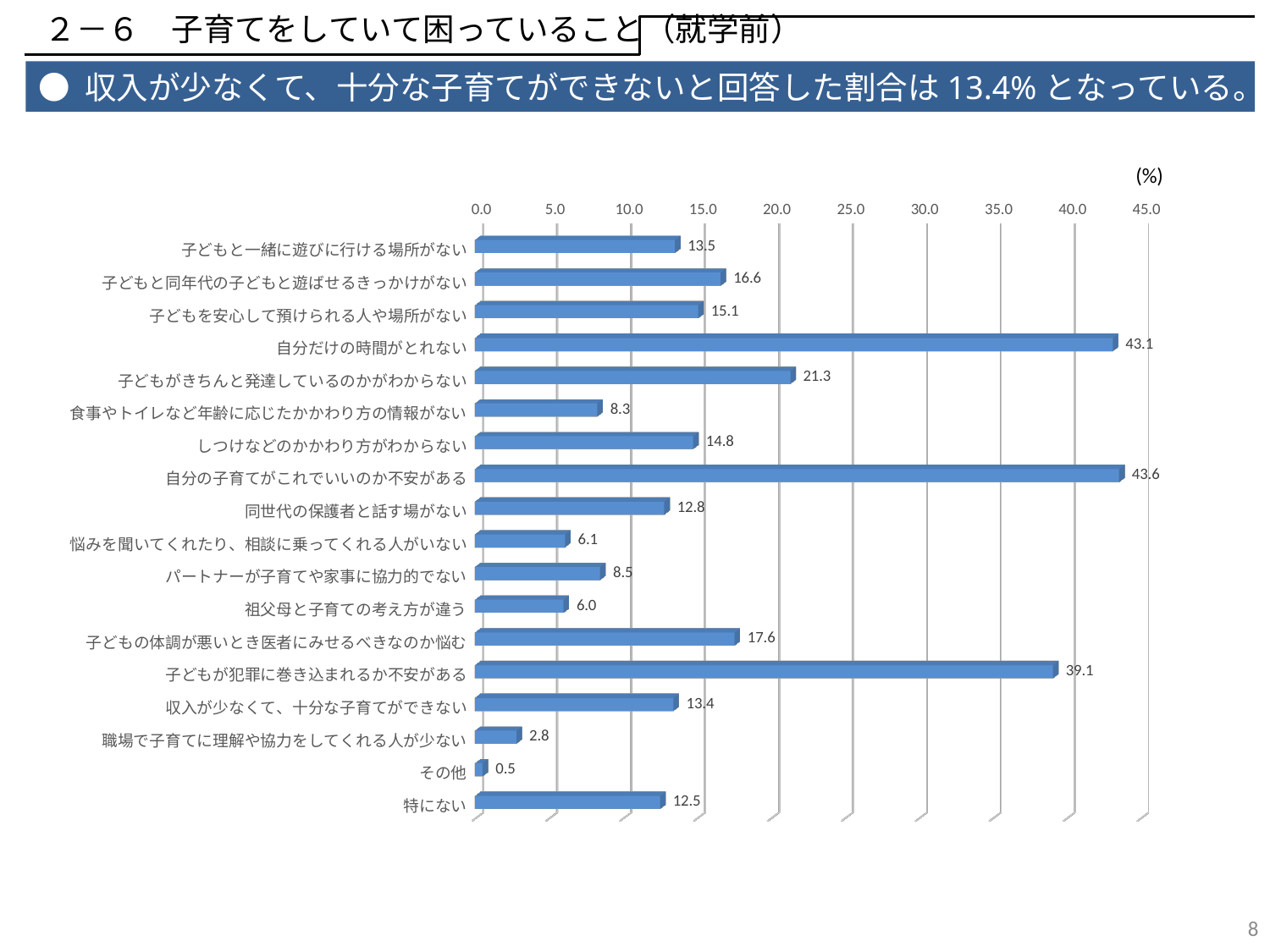
Which category has the lowest value? その他 What is the value for 子どもが犯罪に巻き込まれるか不安がある? 39.1 What unit is indicated at the top right of the chart's axis? (%) What is the value for 特にない? 12.5 What kind of chart is shown on the slide? bar chart Which category has the highest value? 自分の子育てがこれでいいのか不安がある How many categories are shown in the chart? 18 What is the difference between the values for 自分の子育てがこれでいいのか不安がある and 子どもが犯罪に巻き込まれるか不安がある? 4.5 Is the value for 自分だけの時間がとれない greater or less than 40.0? greater What is the value for 収入が少なくて、十分な子育てができない? 13.4 Which is larger: the value for 子どもがきちんと発達しているのかがわからない or the value for 子どもの体調が悪いとき医者にみせるべきなのか悩む? 子どもがきちんと発達しているのかがわからない What is the value for 自分だけの時間がとれない? 43.1